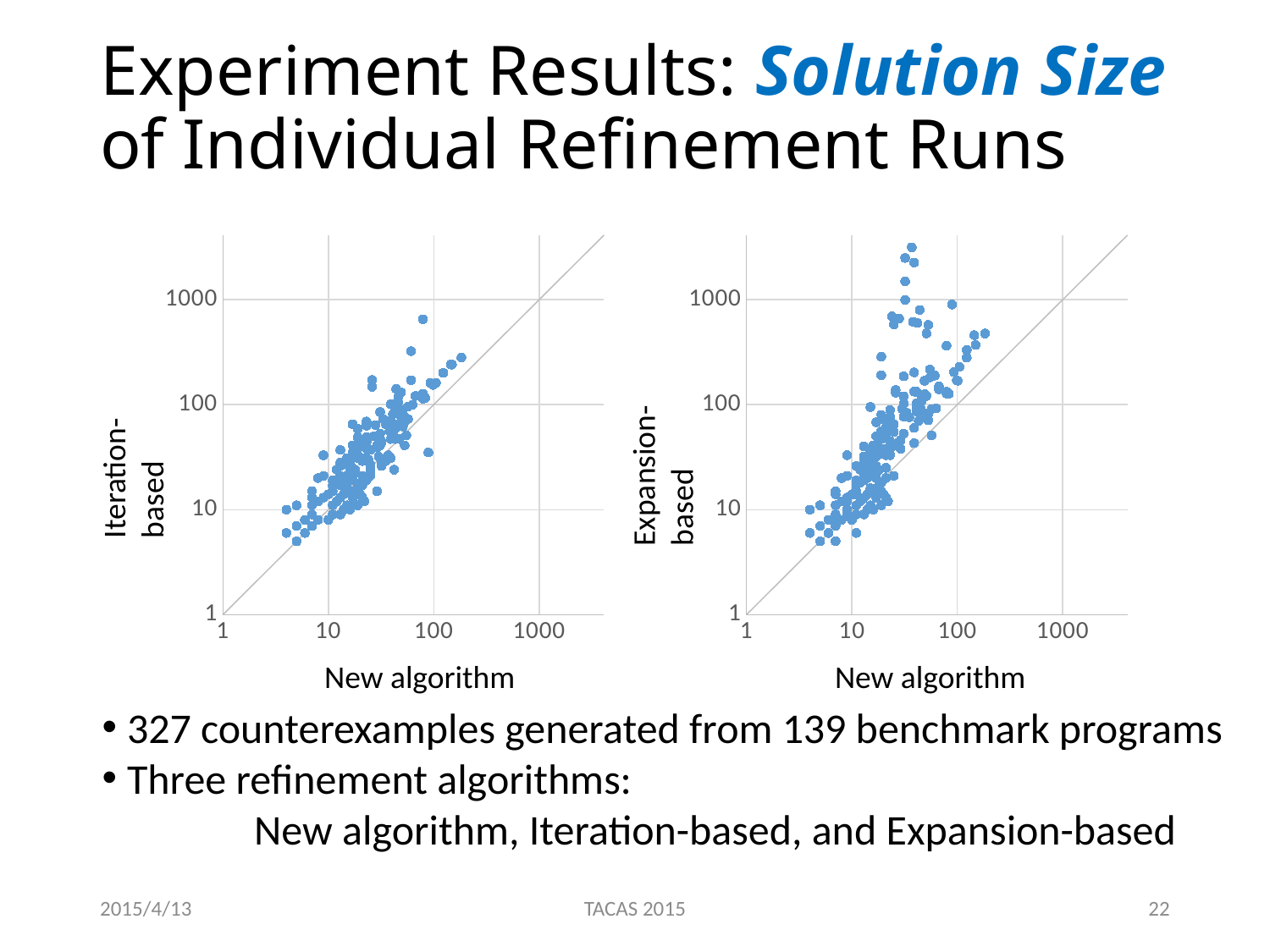
Which chart contains points with y values above 1000, the left (Iteration-based) or the right (Expansion-based)? Right (Expansion-based) In the right chart (Expansion-based), is the smallest plotted y value greater or less than 10? less What kind of chart is the right chart (Expansion-based vs New algorithm)? Scatter chart In the left chart (Iteration-based), do the y values generally rise or fall as the x value (New algorithm) increases? Rise What is the highest tick value shown on the x axis of the right chart? 1000 What is the x-axis label of the left chart? New algorithm How many charts are shown on the slide? 2 In the right chart (Expansion-based), is the highest plotted y value greater or less than 1000? greater What kind of chart is the left chart (Iteration-based vs New algorithm)? Scatter chart In the left chart (Iteration-based), is the largest x value (New algorithm) greater or less than 1000? less What is the y-axis label of the right chart? Expansion-based